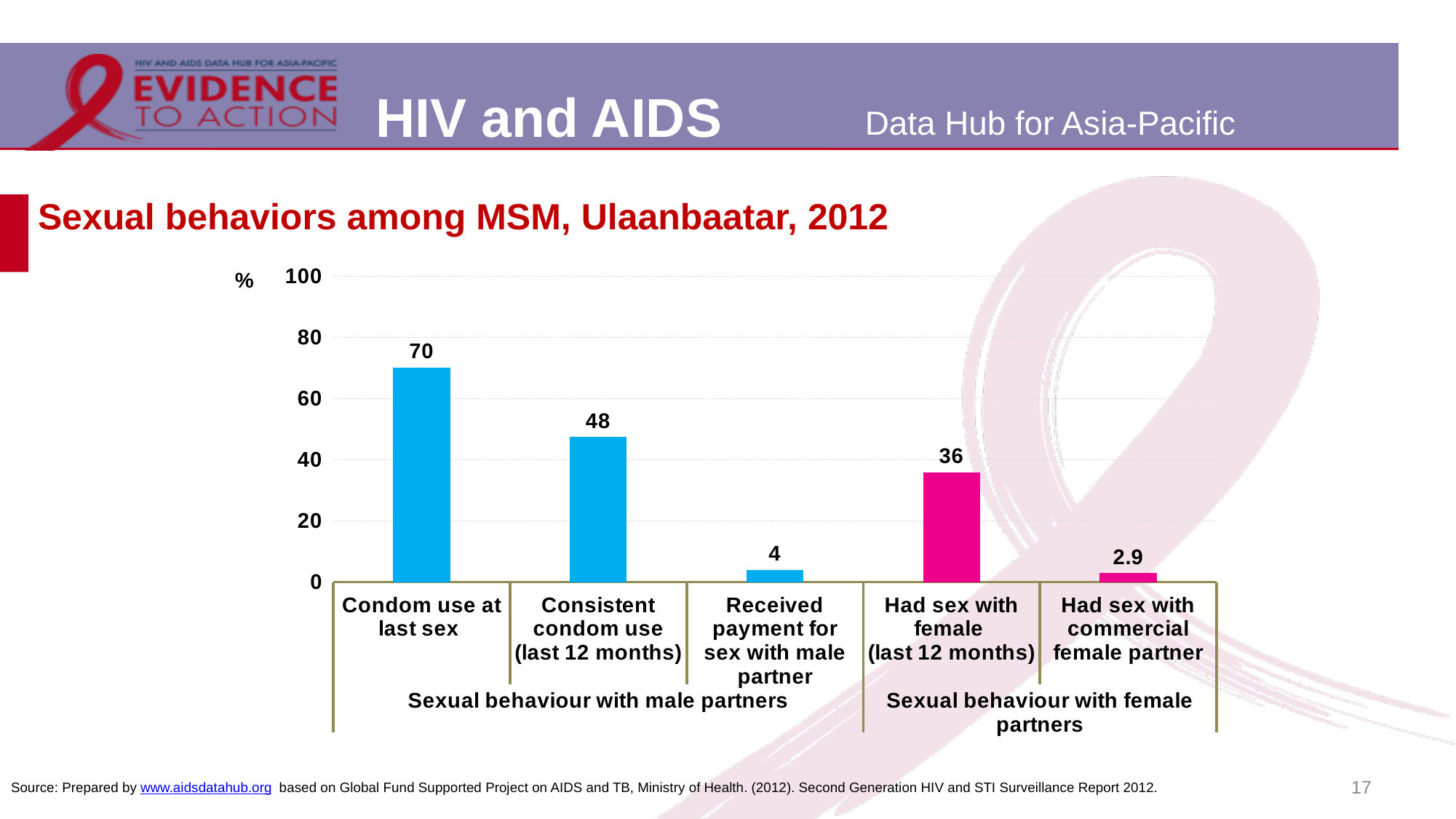
What is the value for Consistent condom use (last 12 months)? 48 Which category has the highest value? Condom use at last sex Which is larger: Consistent condom use (last 12 months) or Had sex with female (last 12 months)? Consistent condom use (last 12 months) What is the value for Had sex with commercial female partner? 2.9 What is the title of the chart? Sexual behaviors among MSM, Ulaanbaatar, 2012 Which category has the lowest value? Had sex with commercial female partner What is the value for Received payment for sex with male partner? 4 What kind of chart is shown on the slide? Bar chart Is the value for Had sex with female (last 12 months) greater or less than 40? less What is the value for Condom use at last sex? 70 How many categories are shown in the chart? 5 What is the difference between Condom use at last sex and Consistent condom use (last 12 months)? 22